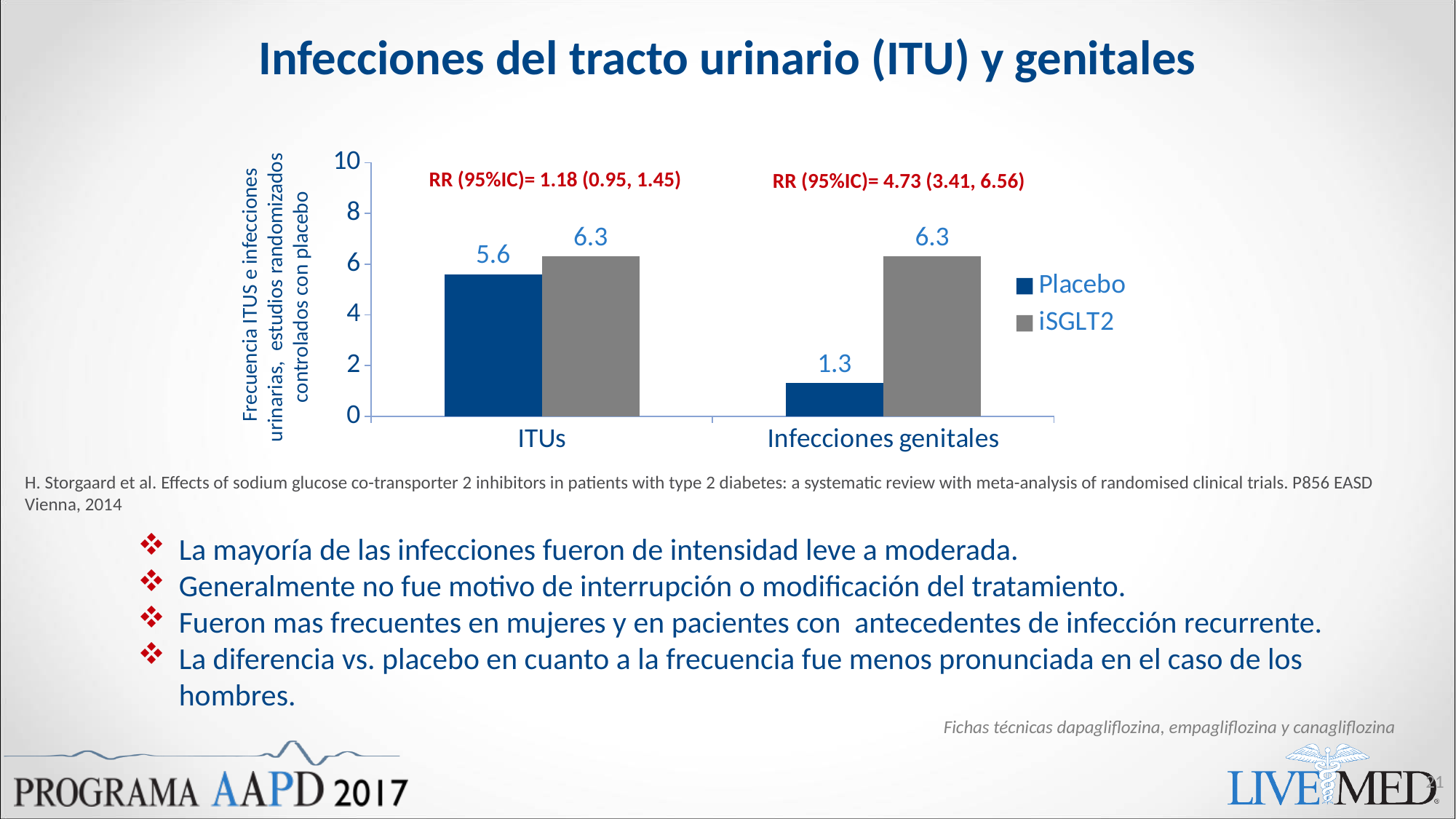
What is the value for iSGLT2 in the ITUs category? 6.3 How many series does the legend list? 2 What is the value for Placebo in the Infecciones genitales category? 1.3 What is the difference between the iSGLT2 and Placebo values in the ITUs category? 0.7 What is the value for iSGLT2 in the Infecciones genitales category? 6.3 How many categories are shown on the x axis? 2 Which is larger in the ITUs category, Placebo or iSGLT2? iSGLT2 Which category has the lowest Placebo value? Infecciones genitales What is the difference between the iSGLT2 and Placebo values in the Infecciones genitales category? 5.0 What is the value for Placebo in the ITUs category? 5.6 What colour are the iSGLT2 bars? Grey What kind of chart is shown on the slide? Bar chart